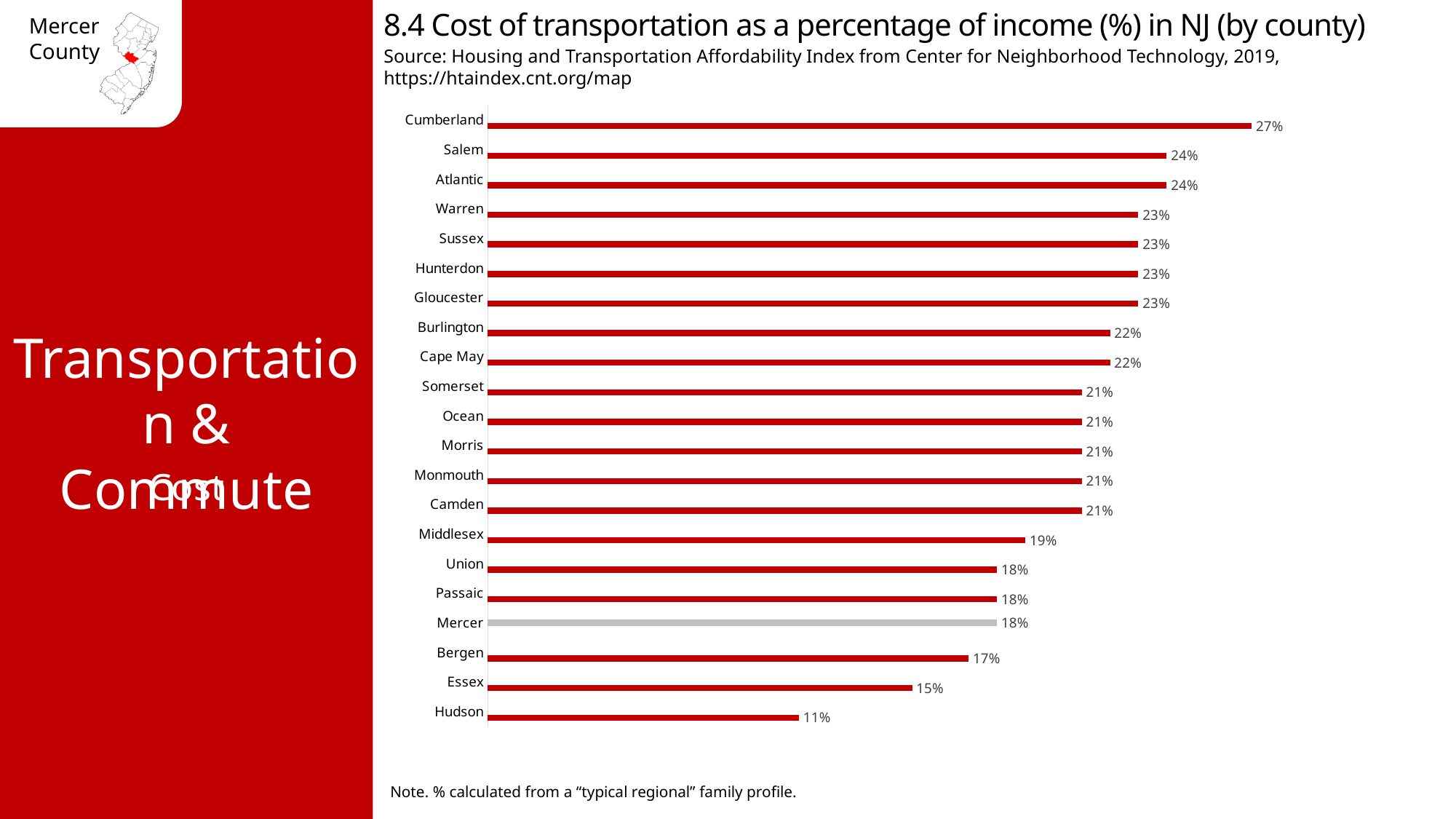
What kind of chart is shown on the slide? Bar chart Which has a higher value, Bergen or Middlesex? Middlesex What is the value shown for Hudson County? 11% Which county has the lowest cost of transportation as a percentage of income? Hudson How many counties are shown in the chart? 21 Which has a higher value, Salem or Burlington? Salem Which county has the highest cost of transportation as a percentage of income? Cumberland What is the difference between the values for Mercer and Essex? 3% Which county's bar is coloured grey instead of red? Mercer What is the cost of transportation as a percentage of income for Mercer County? 18% What is the difference between the values for Cumberland and Hudson? 16% What is the cost of transportation as a percentage of income for Cumberland County? 27%